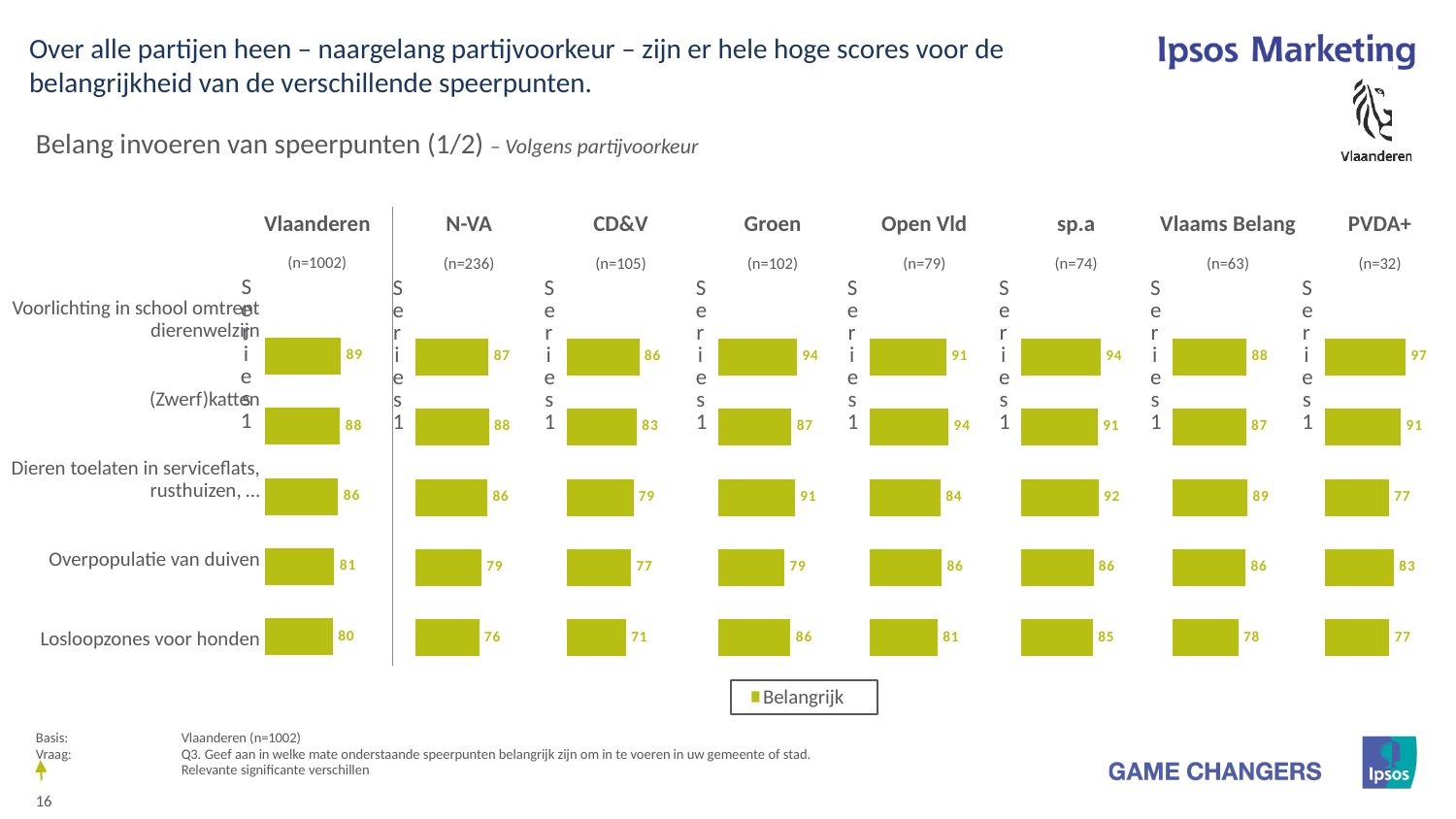
How many series does the legend list? 1 In the PVDA+ chart, what is the value for Voorlichting in school omtrent dierenwelzijn? 97 In the sp.a chart, which is larger: the value for Dieren toelaten in serviceflats, rusthuizen or the value for Losloopzones voor honden? Dieren toelaten in serviceflats, rusthuizen In the Open Vld chart, which category has the highest value? (Zwerf)katten In the CD&V chart, what is the value for Losloopzones voor honden? 71 In the Groen chart, what is the difference between the values for Voorlichting in school omtrent dierenwelzijn and Overpopulatie van duiven? 15 What is the legend entry shown below the charts? Belangrijk In the Vlaanderen chart, what is the value for Voorlichting in school omtrent dierenwelzijn? 89 In the Vlaanderen chart, which category has the lowest value? Losloopzones voor honden How many categories are shown in the N-VA chart? 5 In the Vlaams Belang chart, what is the value for Overpopulatie van duiven? 86 What kind of chart is used for the Vlaams Belang column? Bar chart